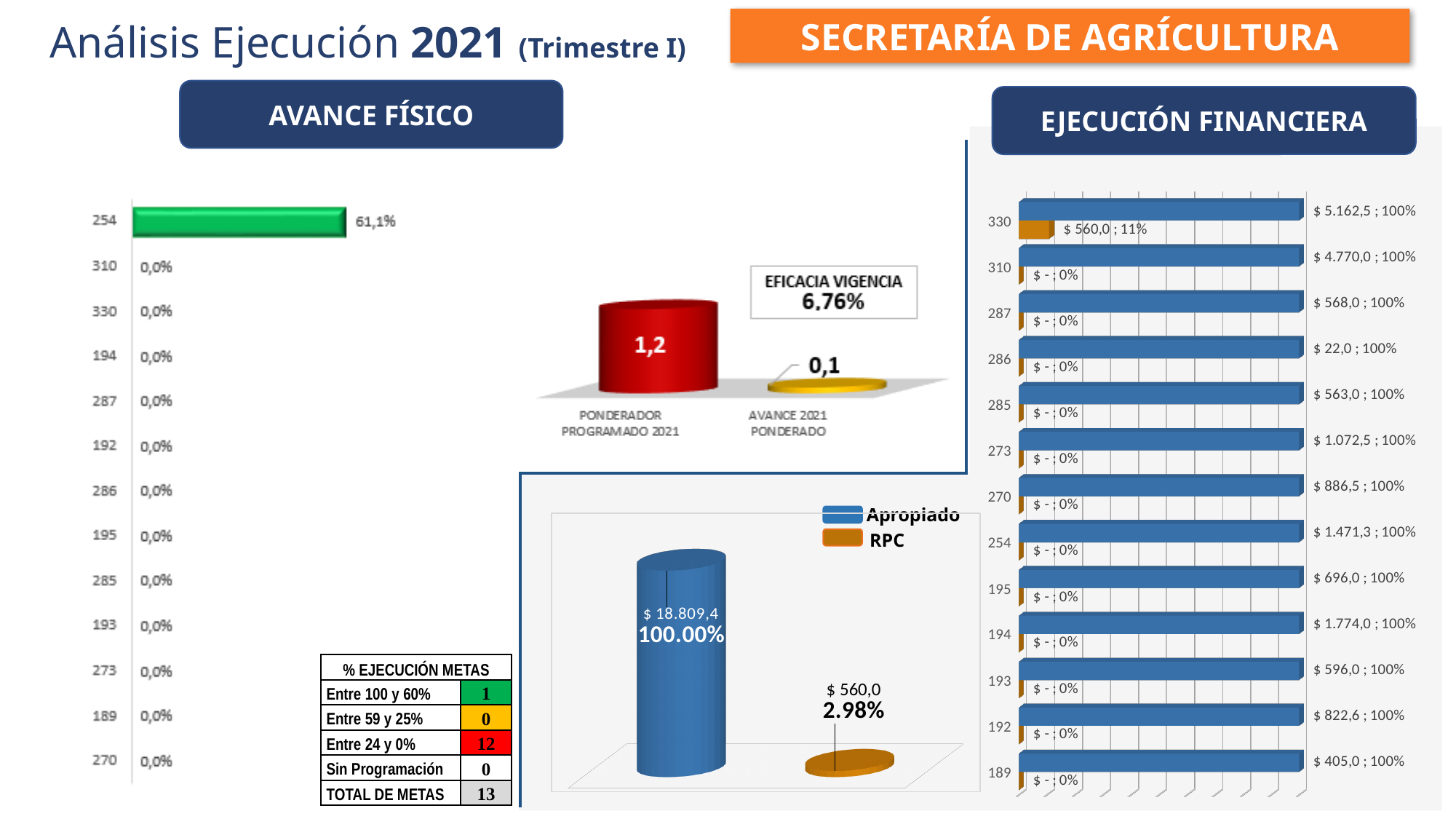
In the cylinder chart with the Eficacia Vigencia label, what is the difference between Ponderador Programado 2021 and Avance 2021 Ponderado? 1,1 How many categories are shown in the Avance Físico bar chart on the left? 13 In the Apropiado/RPC cylinder chart at the bottom centre, what is the value for Apropiado? $ 18.809,4 In the Ejecución Financiera chart on the right, what is the RPC percentage for category 330? 11% In the Ejecución Financiera chart on the right, which category has the lowest Apropiado value? 286 In the cylinder chart with the Eficacia Vigencia label, what is the value for Ponderador Programado 2021? 1,2 In the Apropiado/RPC cylinder chart at the bottom centre, what percentage is shown for RPC? 2.98% In the Avance Físico bar chart on the left, what is the value for category 254? 61,1% In the cylinder chart with the Eficacia Vigencia label, what is the value for Avance 2021 Ponderado? 0,1 In the Avance Físico bar chart on the left, which category has the highest value? 254 In the Ejecución Financiera chart on the right, what is the Apropiado value for category 330? $ 5.162,5 How many series does the legend of the Apropiado/RPC cylinder chart list? 2